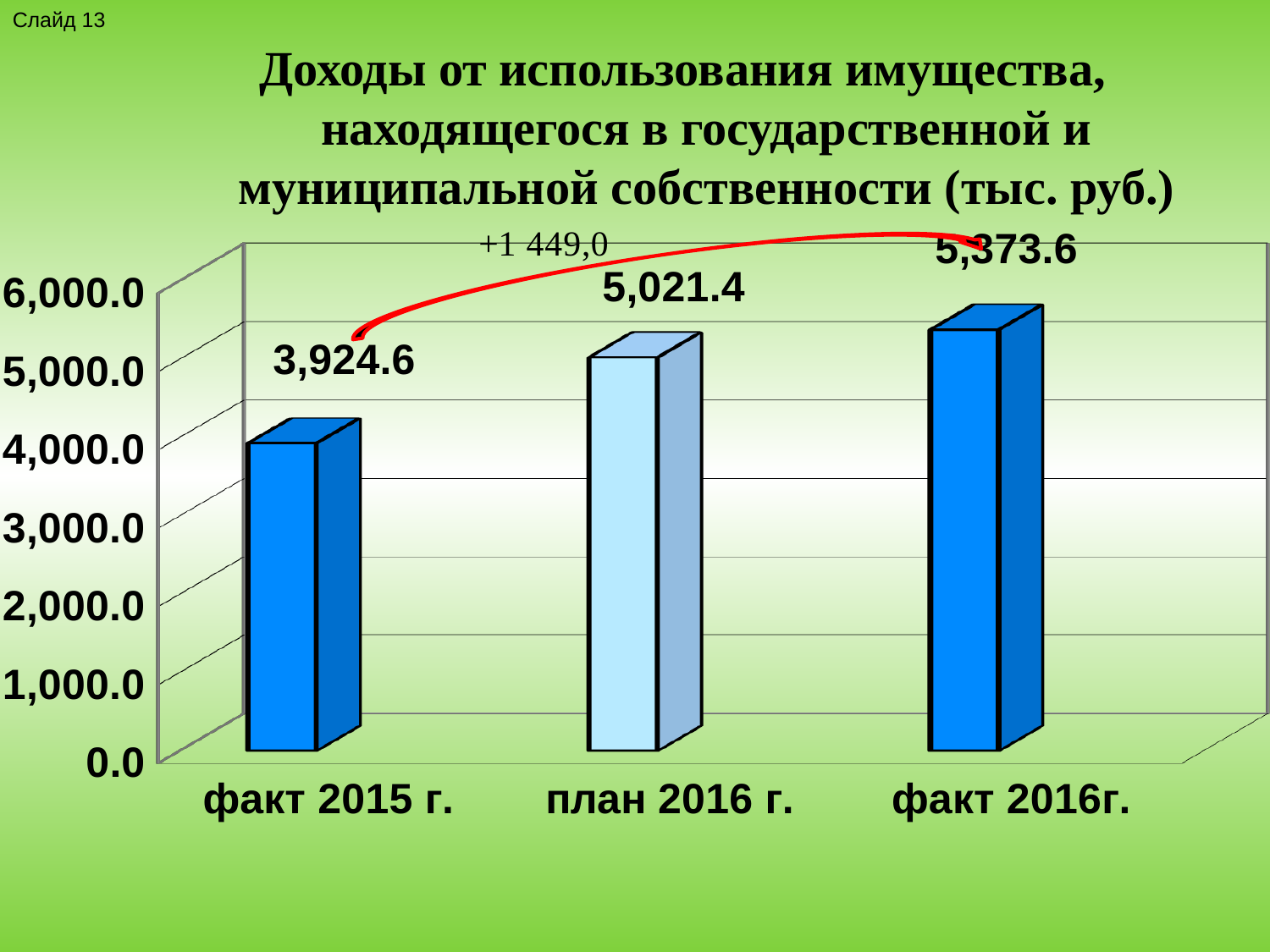
Do the values rise or fall from факт 2015 г. to факт 2016г.? rise What is the difference between факт 2016г. and факт 2015 г.? 1,449.0 Which is larger, план 2016 г. or факт 2015 г.? план 2016 г. What is the value for факт 2015 г.? 3,924.6 What is the value for факт 2016г.? 5,373.6 Is the value for факт 2015 г. greater or less than 4,000.0? less Which category has the lowest value? факт 2015 г. Which category has the highest value? факт 2016г. How many categories are shown on the chart? 3 What is the value for план 2016 г.? 5,021.4 What is the difference between факт 2016г. and план 2016 г.? 352.2 What kind of chart is shown on the slide? bar chart